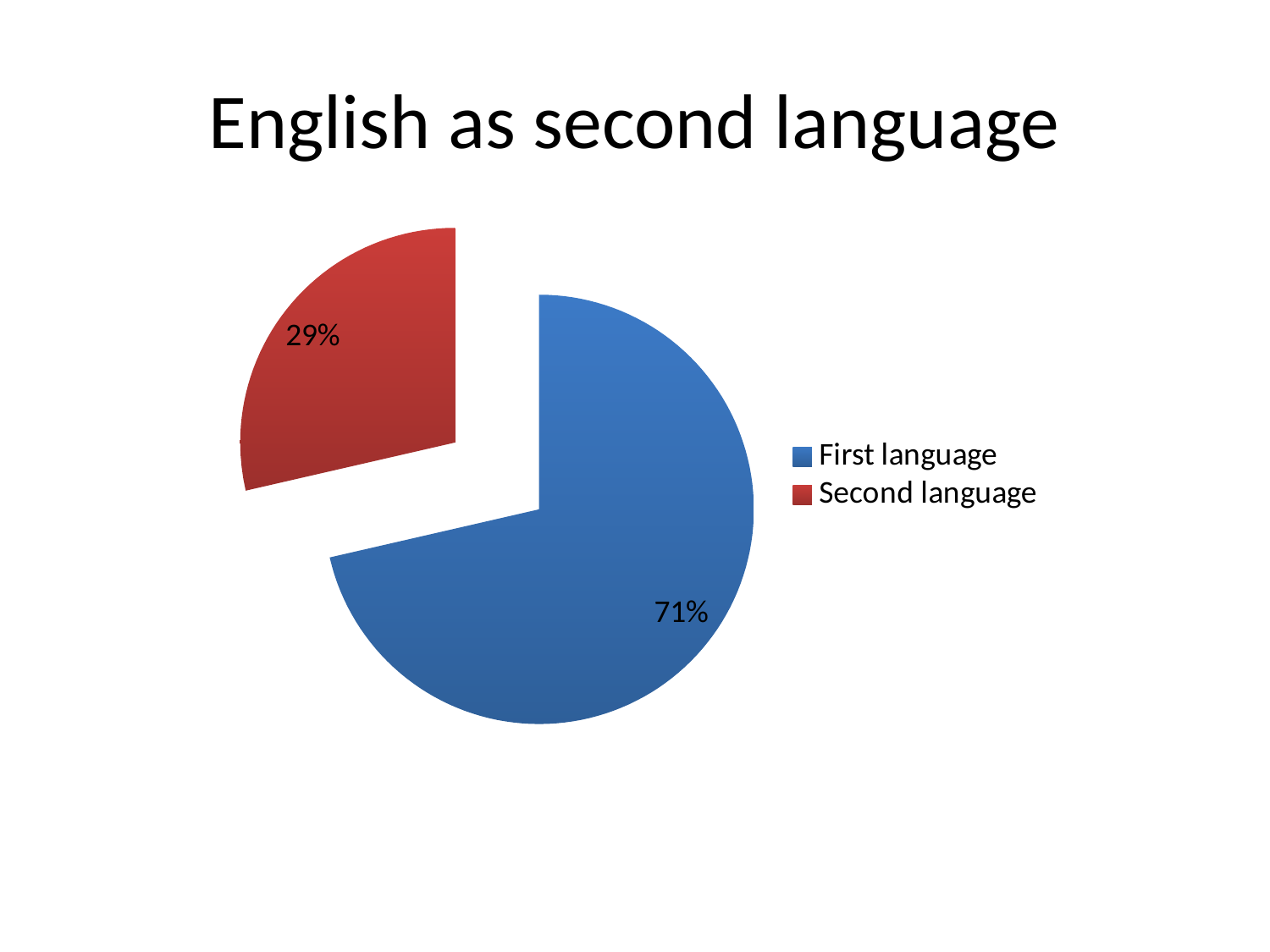
What share of the pie is labelled First language? 71% How many entries does the legend list? 2 What kind of chart is shown on the slide? pie chart What colour is the Second language slice? red Which is larger, the First language slice or the Second language slice? First language What is the title of the slide? English as second language How many slices does the pie chart have? 2 What is the difference in percentage points between the First language and Second language slices? 42 What share of the pie is labelled Second language? 29% Which slice of the pie is the largest? First language Which slice of the pie is the smallest? Second language Is the share for Second language greater or less than 50%? less